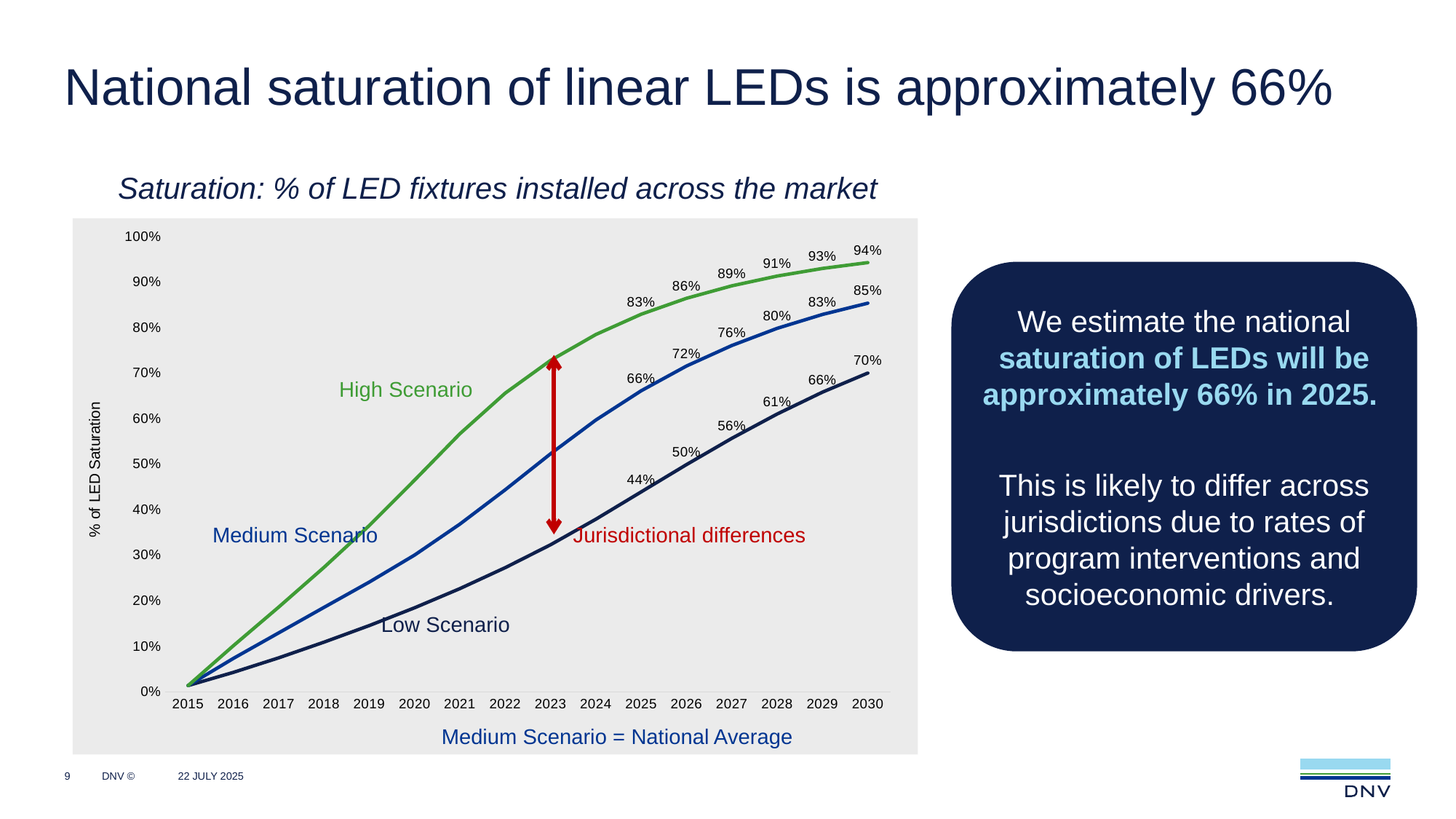
Which scenario has the highest value in 2030? High Scenario What is the difference between the Medium Scenario values in 2030 and 2025? 19% What is the Low Scenario value for 2027? 56% Which scenario has the lowest value in 2028? Low Scenario Do the values of the Low Scenario rise or fall from 2015 to 2030? rise What is the Medium Scenario value for 2025? 66% What is the difference between the High Scenario and Low Scenario values in 2025? 39% How many years are shown on the x axis? 16 What is the High Scenario value for 2030? 94% What type of chart is shown on the slide? line chart Is the High Scenario value for 2020 greater or less than 40%? greater Is the Medium Scenario value in 2026 larger than the Low Scenario value in 2029? Yes, 72% vs 66%